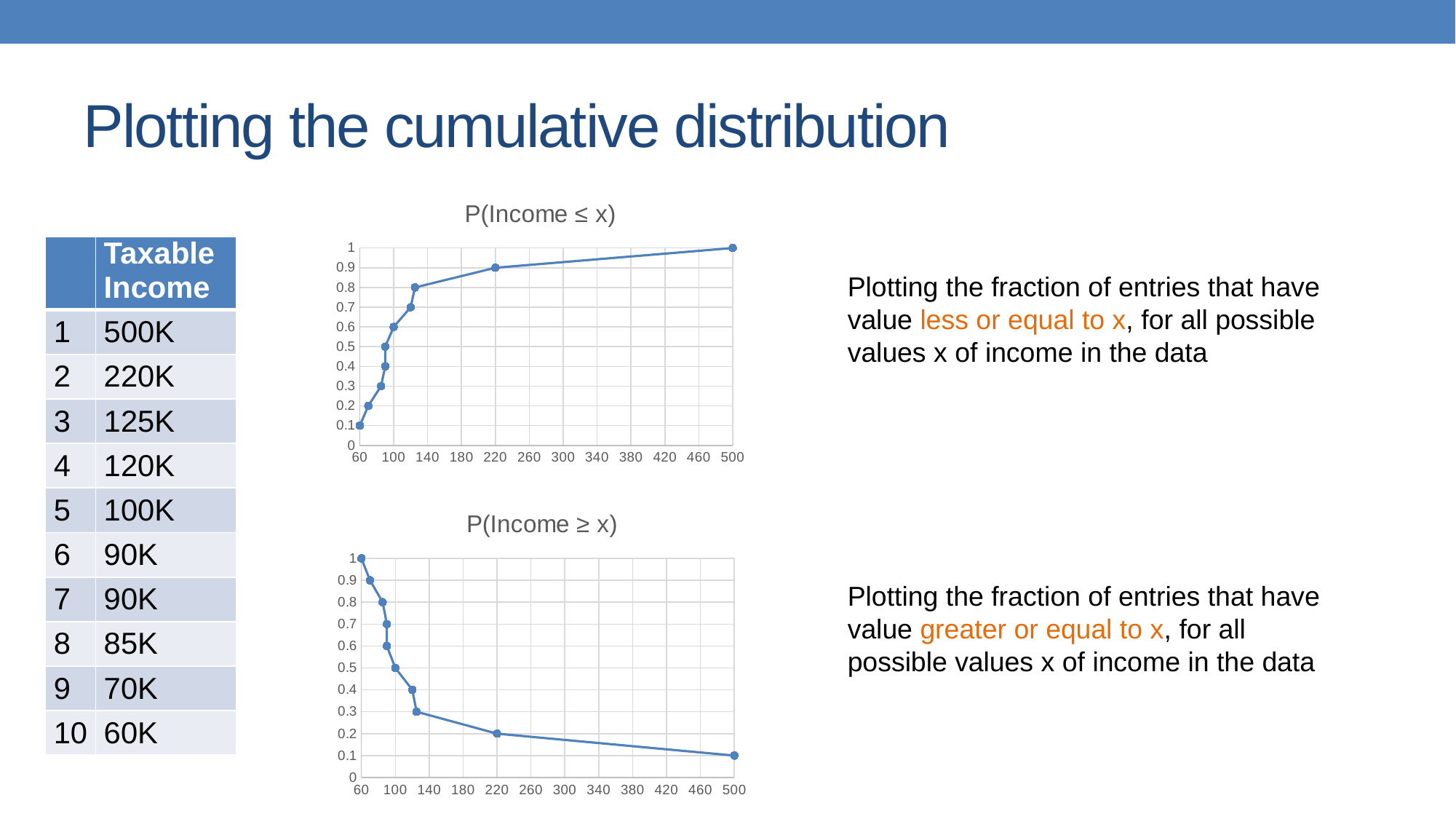
In the top chart P(Income ≤ x), do the values rise or fall as x increases? rise How many data points are plotted in the top chart P(Income ≤ x)? 10 In the top chart P(Income ≤ x), what is the difference between the value at x = 500 and the value at x = 220? 0.1 In the bottom chart P(Income ≥ x), what is the value at x = 220? 0.2 What kind of chart is the top chart titled P(Income ≤ x)? line chart In the bottom chart P(Income ≥ x), what is the value at x = 500? 0.1 What is the title of the bottom chart? P(Income ≥ x) In the top chart P(Income ≤ x), what is the value at x = 500? 1 In the bottom chart P(Income ≥ x), do the values rise or fall as x increases? fall In the bottom chart P(Income ≥ x), what is the value at x = 60? 1 In the bottom chart P(Income ≥ x), which x value has the lowest plotted value? 500 In the top chart P(Income ≤ x), what is the value at x = 220? 0.9